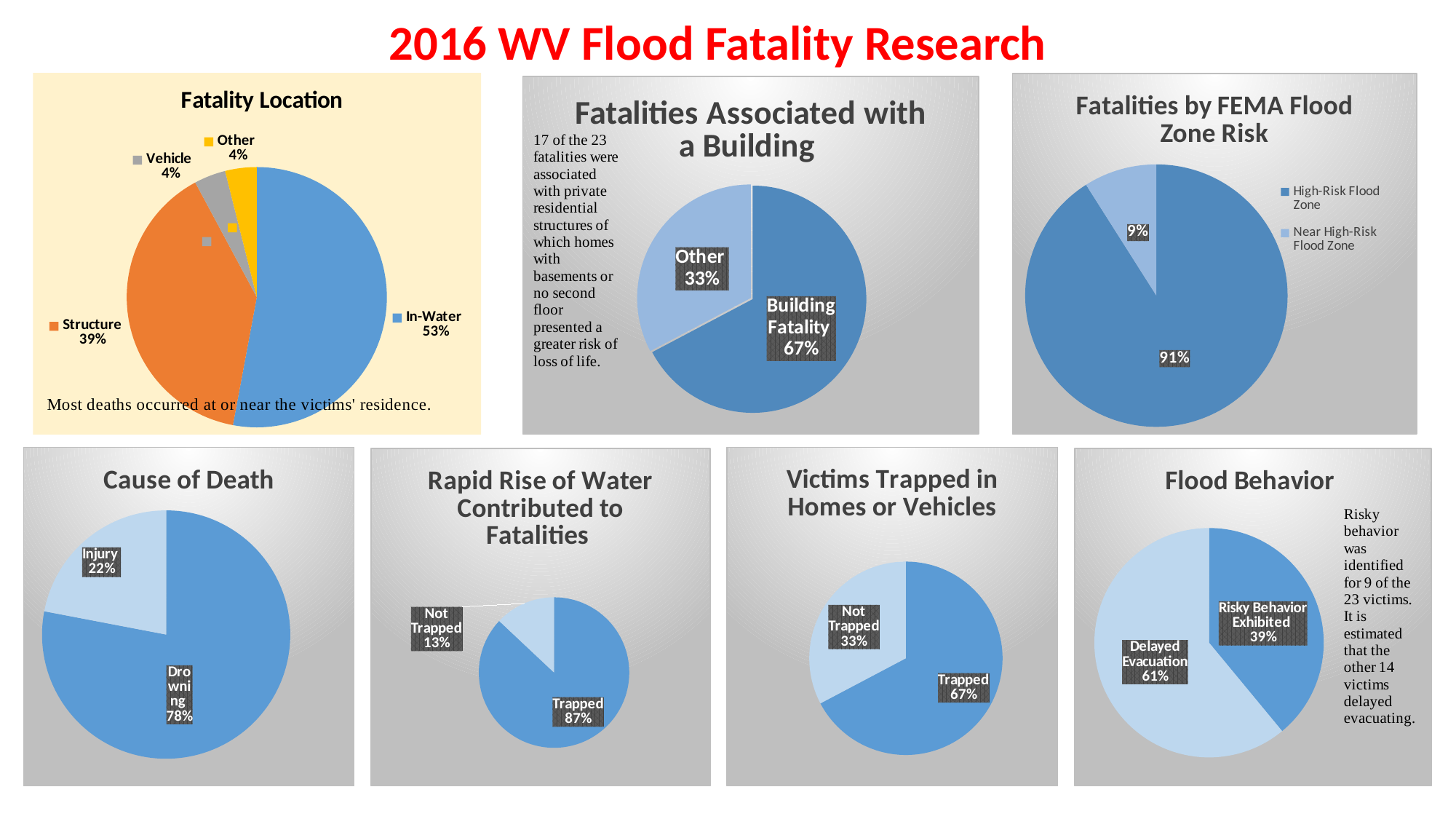
In the 'Fatality Location' chart, what share of fatalities occurred In-Water? 53% In the 'Fatalities by FEMA Flood Zone Risk' chart, how many entries does the legend list? 2 In the 'Fatalities Associated with a Building' chart, what share is labelled Building Fatality? 67% In the 'Fatality Location' chart, what is the difference between the Structure share and the Vehicle share? 35% In the 'Cause of Death' chart, what share of deaths were due to Injury? 22% In the 'Fatality Location' chart, which category has the largest share? In-Water In the 'Fatalities by FEMA Flood Zone Risk' chart, what share of fatalities were in the High-Risk Flood Zone? 91% In the 'Victims Trapped in Homes or Vehicles' chart, what share were Not Trapped? 33% In the 'Rapid Rise of Water Contributed to Fatalities' chart, which is larger, Trapped or Not Trapped? Trapped What type of chart is the 'Cause of Death' chart? Pie chart In the 'Flood Behavior' chart, what share is labelled Delayed Evacuation? 61% In the 'Fatality Location' chart, how many categories are shown? 4